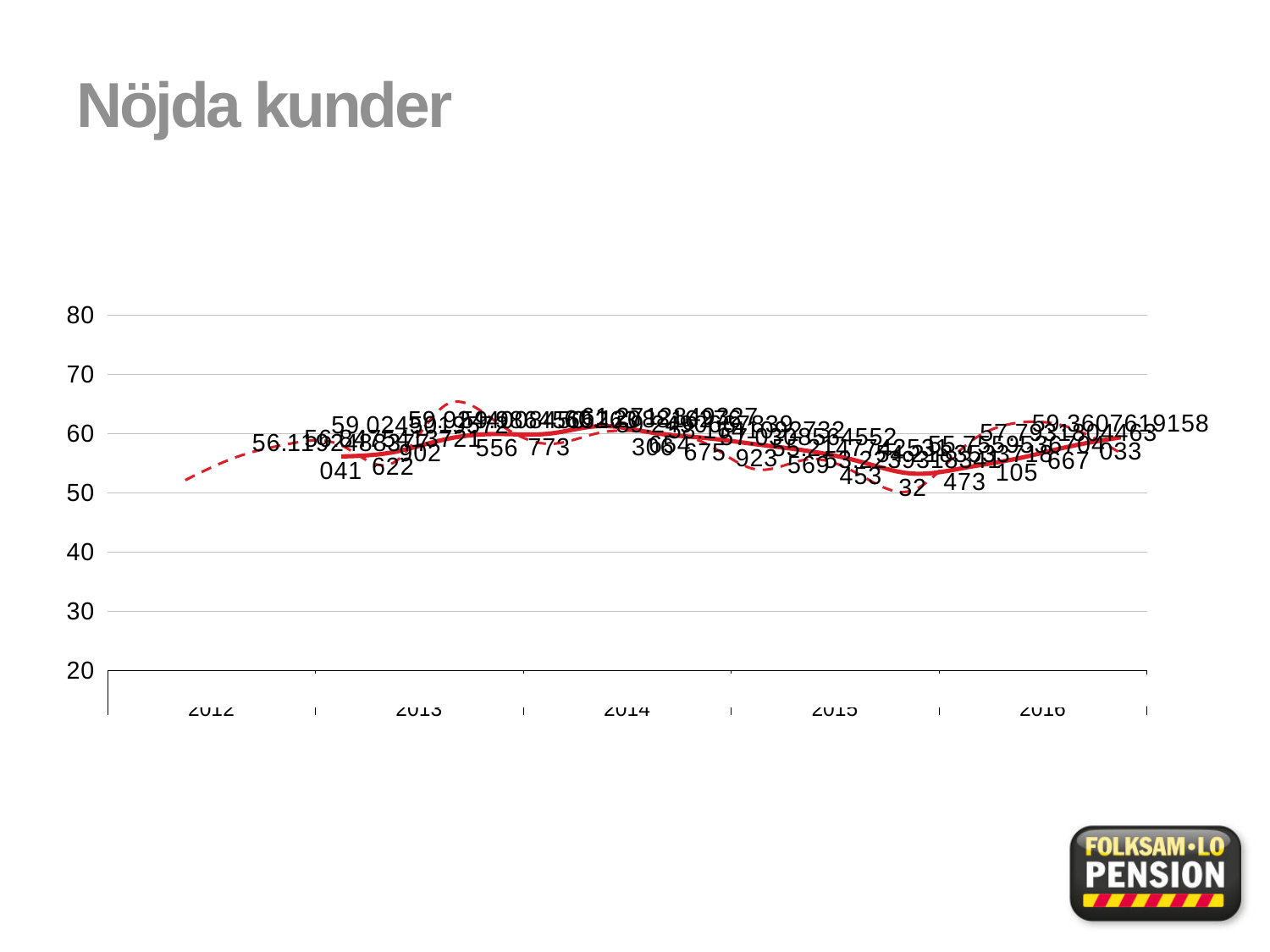
Are all the plotted values in the chart greater or less than 40? greater Which years are labelled on the x axis of the chart? 2012, 2013, 2014, 2015, 2016 Is the first plotted value of the dashed line, at 2012, greater or less than 60? less Does the dashed line rise or fall between 2012 and 2013? rise What kind of chart is shown on the slide? line chart Are all the plotted values in the chart greater or less than 70? less What is the title of the chart on the slide? Nöjda kunder How many year labels are shown along the x axis of the chart? 5